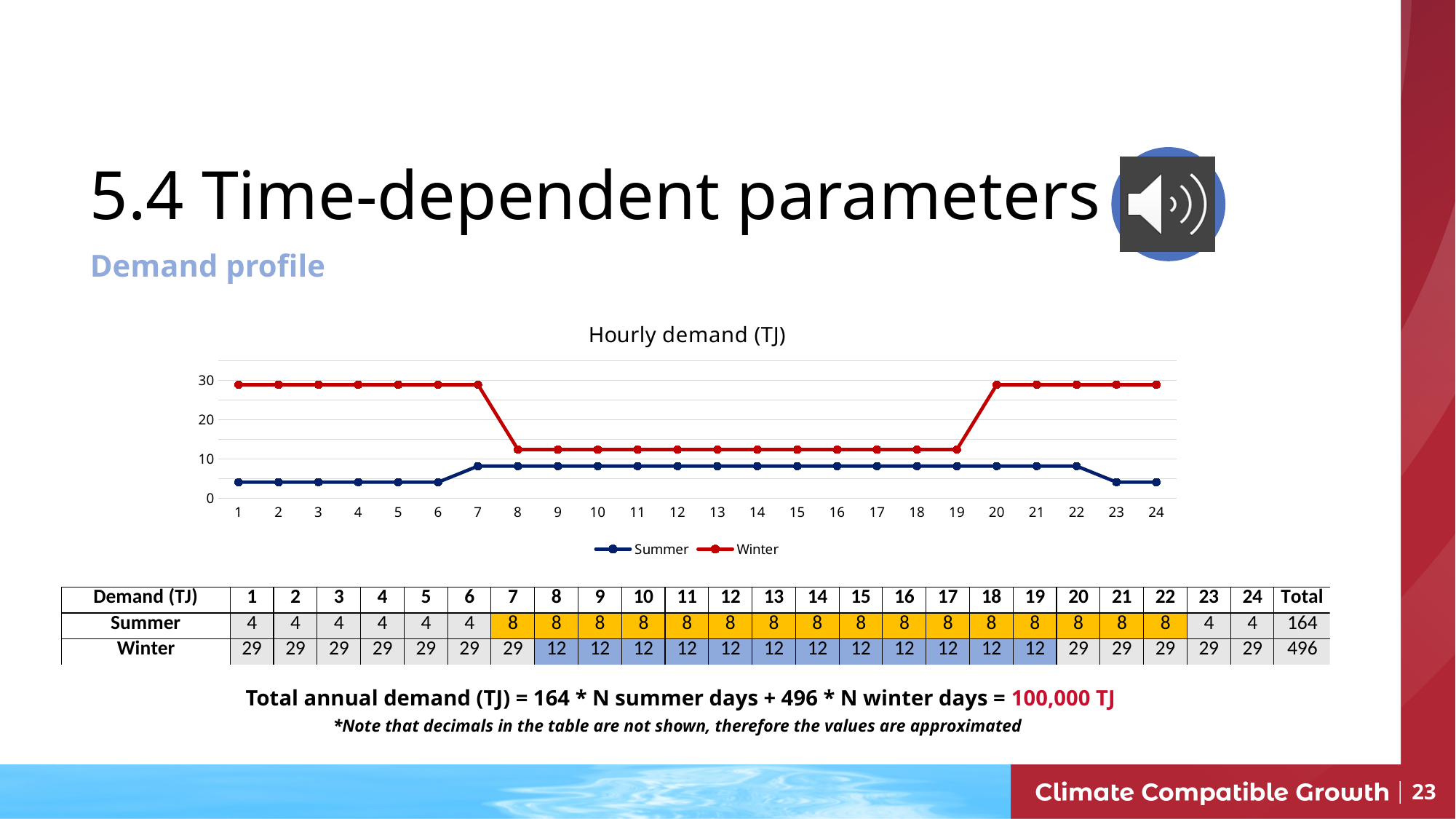
What colour is the Winter line in the chart? Red Is the Summer value at hour 2 greater or less than 10? less Is the Winter value at hour 3 greater or less than 20? greater Does the Winter line rise or fall between hour 7 and hour 8? Falls How many series does the chart legend list? 2 How many hours are plotted along the x axis of the chart? 24 Is the Winter value at hour 10 greater or less than 20? less What is the title of the chart? Hourly demand (TJ) Does the Summer line rise or fall between hour 6 and hour 7? Rises What kind of chart is shown on the slide? Line chart At hour 12, which series has the higher value, Summer or Winter? Winter